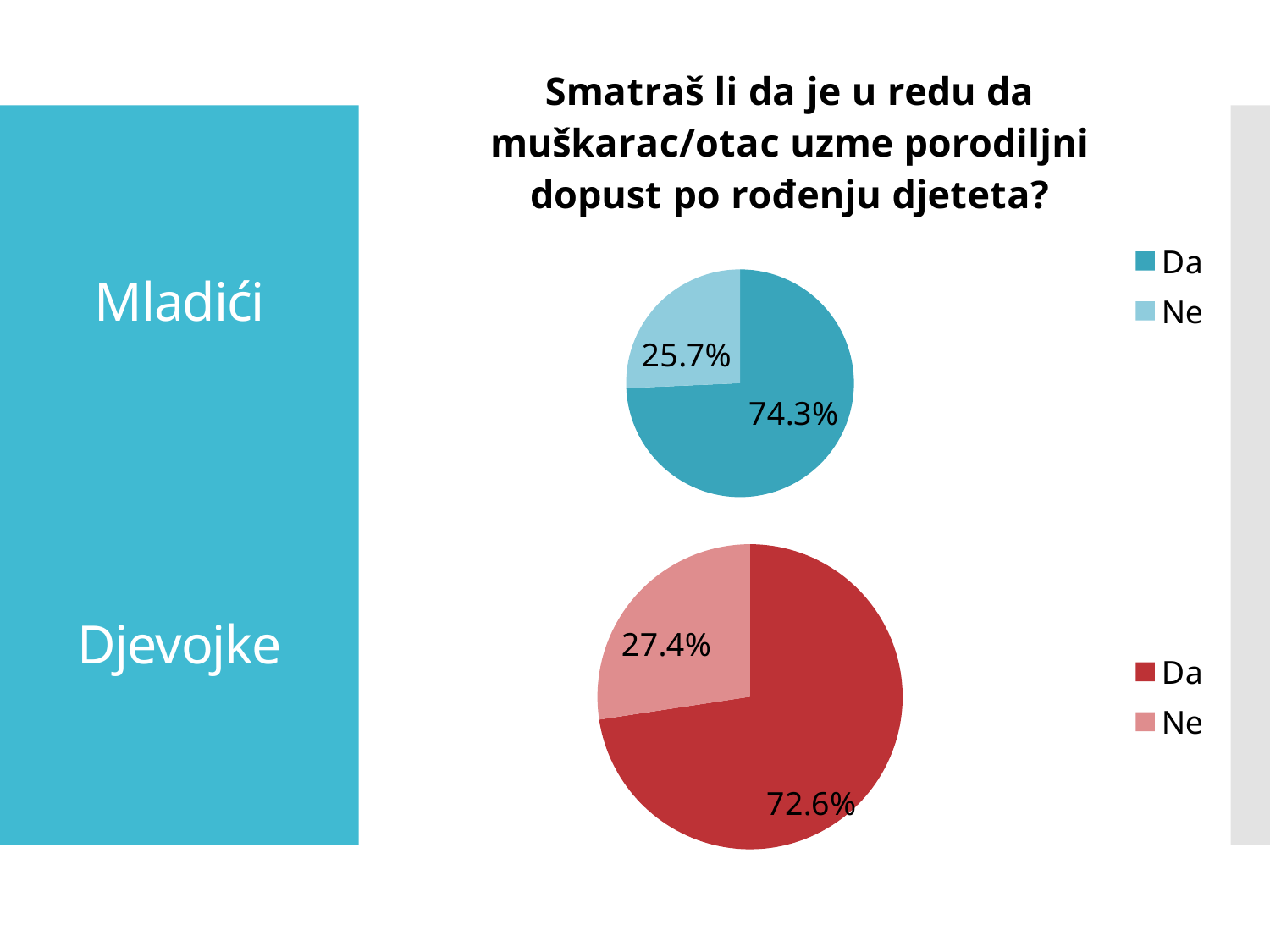
How many entries does the legend of the top pie chart (Mladići) list? 2 In the top pie chart (Mladići), which answer has the largest share? Da In the top pie chart (Mladići), what percentage answered Da? 74.3% What question is shown as the title above the pie charts? Smatraš li da je u redu da muškarac/otac uzme porodiljni dopust po rođenju djeteta? In the bottom pie chart (Djevojke), what percentage answered Da? 72.6% In the top pie chart (Mladići), what percentage answered Ne? 25.7% In the bottom pie chart (Djevojke), what percentage answered Ne? 27.4% In the top pie chart (Mladići), what is the difference between the Da and Ne shares? 48.6% In the bottom pie chart (Djevojke), which answer has the smallest share? Ne How many slices does the bottom pie chart (Djevojke) have? 2 Which is larger: the Da share in the top pie chart (Mladići) or the Da share in the bottom pie chart (Djevojke)? Mladići What type of chart is used on this slide? Pie chart